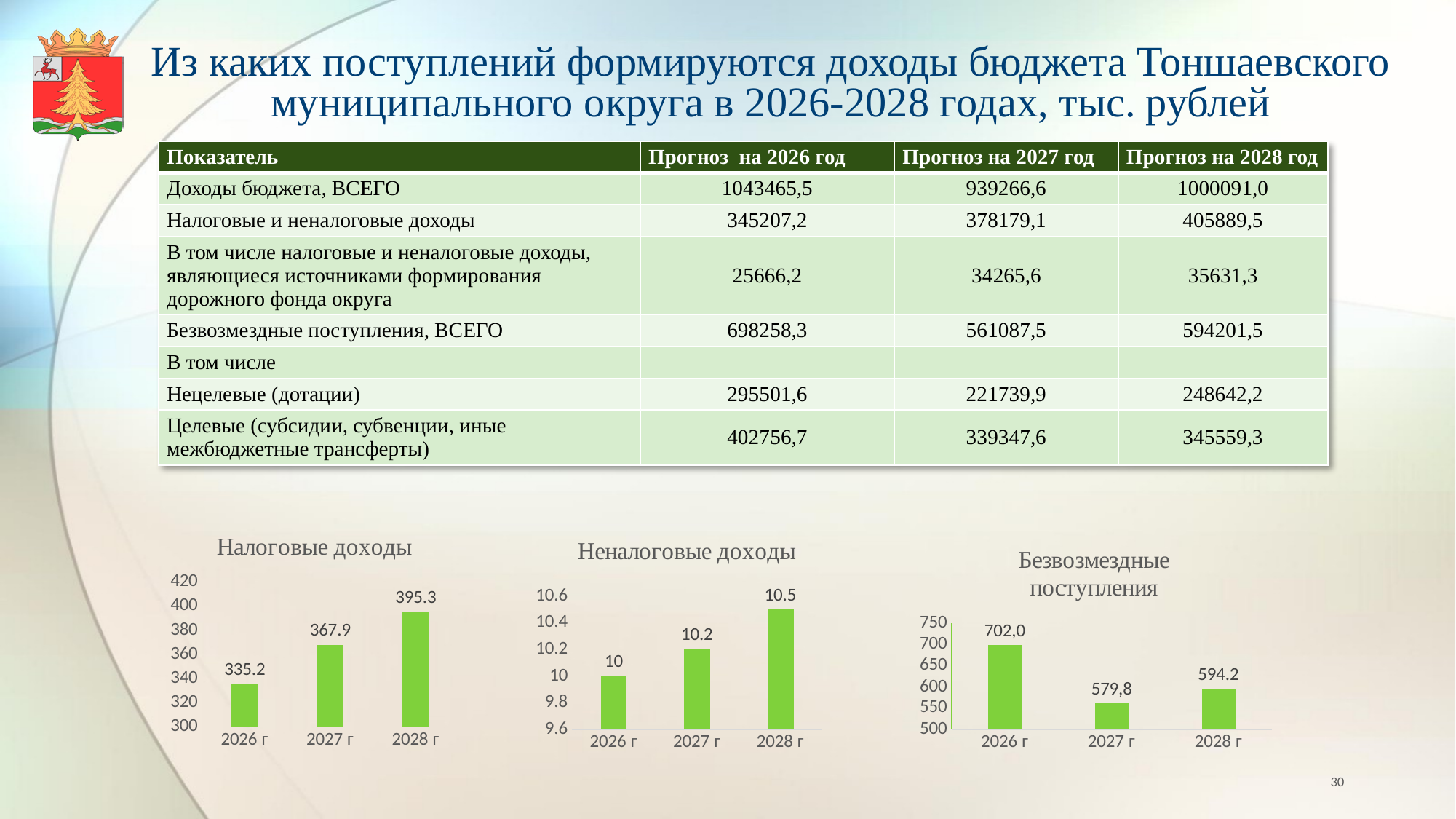
In the "Безвозмездные поступления" chart, which year has the lowest value? 2027 г In the "Неналоговые доходы" chart, which year has the lowest value? 2026 г In the "Налоговые доходы" chart, what is the value for 2028 г? 395.3 In the "Неналоговые доходы" chart, how many bars are plotted? 3 In the "Безвозмездные поступления" chart, what is the value for 2026 г? 702,0 In the "Налоговые доходы" chart, what is the difference between the 2028 г and 2026 г values? 60.1 In the "Безвозмездные поступления" chart, is the value for 2027 г greater or less than 600? less In the "Налоговые доходы" chart, do the values rise or fall from 2026 г to 2028 г? rise In the "Неналоговые доходы" chart, what is the value for 2027 г? 10.2 In the "Безвозмездные поступления" chart, which is larger, the value for 2027 г or for 2028 г? 2028 г What kind of chart is the "Налоговые доходы" chart? bar chart In the "Налоговые доходы" chart, what is the value for 2026 г? 335.2